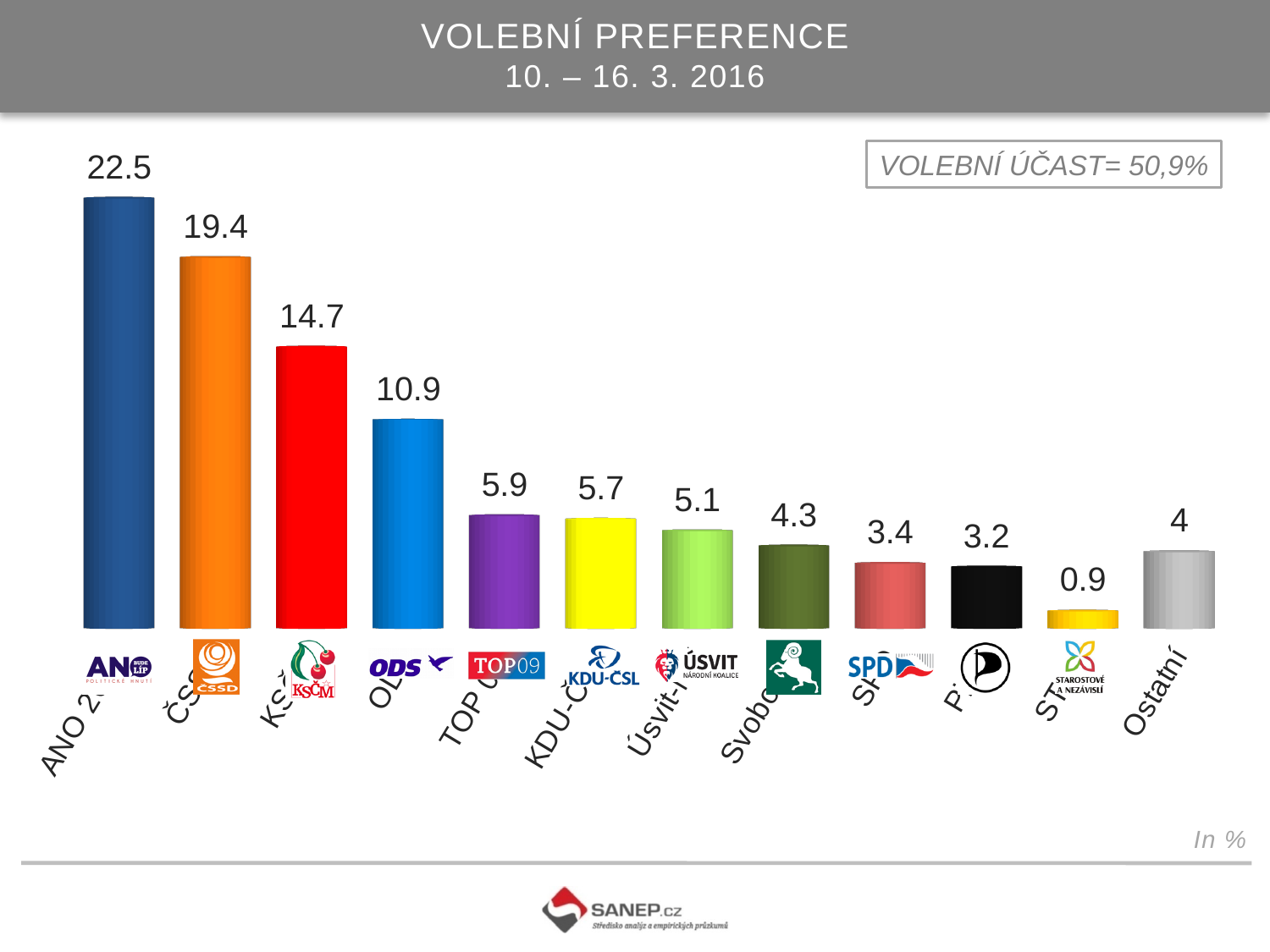
What is the difference between the values for KSČM and ODS? 3.8 What is the value for KDU-ČSL? 5.7 What kind of chart is shown on the slide? Bar chart Which party has the highest value? ANO 2011 What is the value for Ostatní? 4 Which is larger, the value for TOP 09 or the value for Úsvit? TOP 09 What is the title of the chart? VOLEBNÍ PREFERENCE 10. – 16. 3. 2016 How many categories are shown in the chart? 12 Which category has the lowest value? STAN What is the difference between the values for ANO 2011 and ČSSD? 3.1 What is the value for ANO 2011? 22.5 What is the value for ODS? 10.9